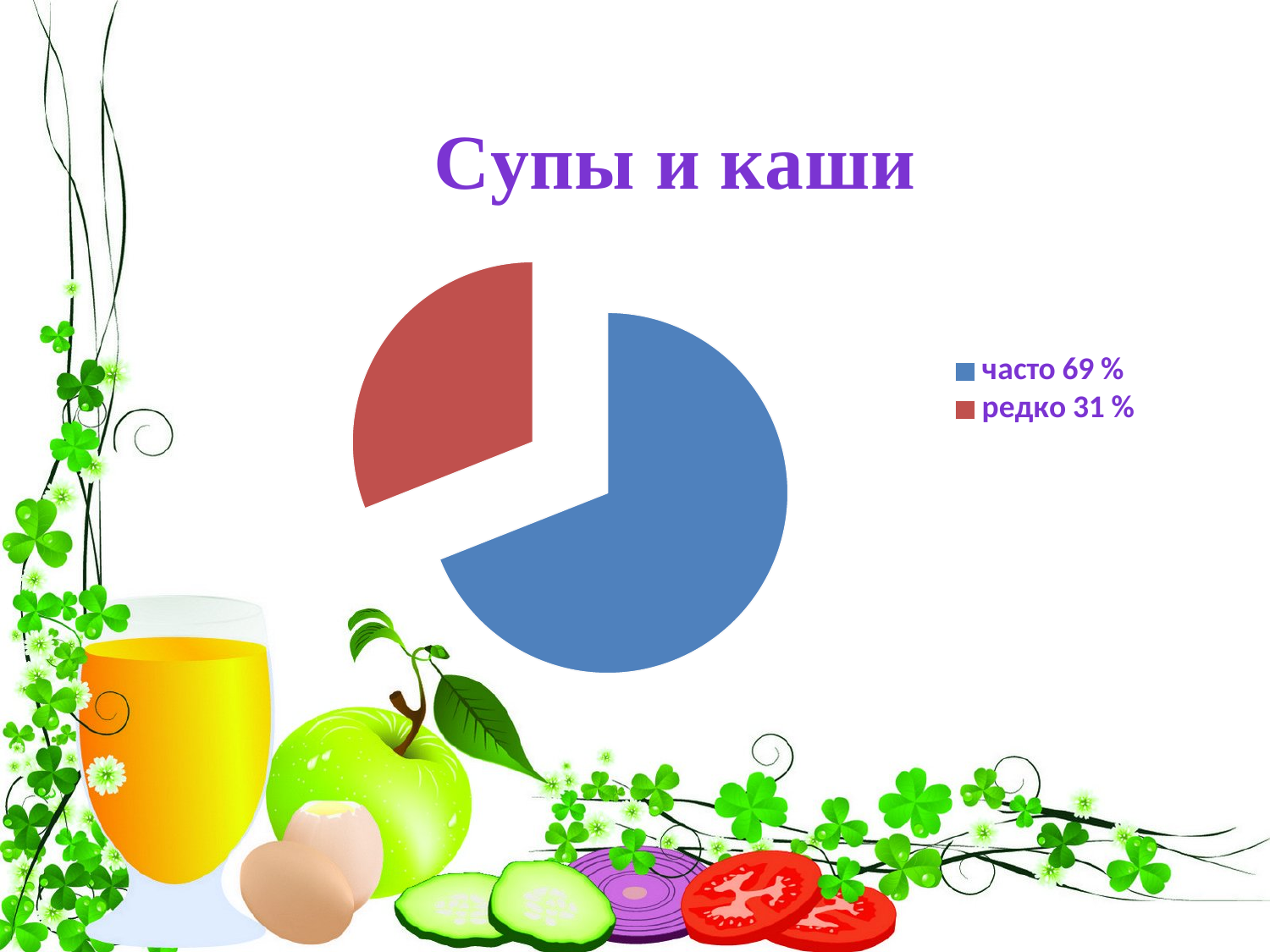
What is the total of the two slices shown in the legend? 100 % What share of the pie does the 'часто' slice represent? 69 % Which slice is the smallest in the pie chart? редко How many entries does the legend list? 2 What share of the pie does the 'редко' slice represent? 31 % What is the difference in percentage points between the 'часто' and 'редко' slices? 38 Which slice is the largest in the pie chart? часто What is the title of the chart on the slide? Супы и каши Which is larger, the 'часто' slice or the 'редко' slice? часто What colour is the 'редко' slice in the pie chart? red What kind of chart is shown on the slide? pie chart How many slices does the pie chart have? 2